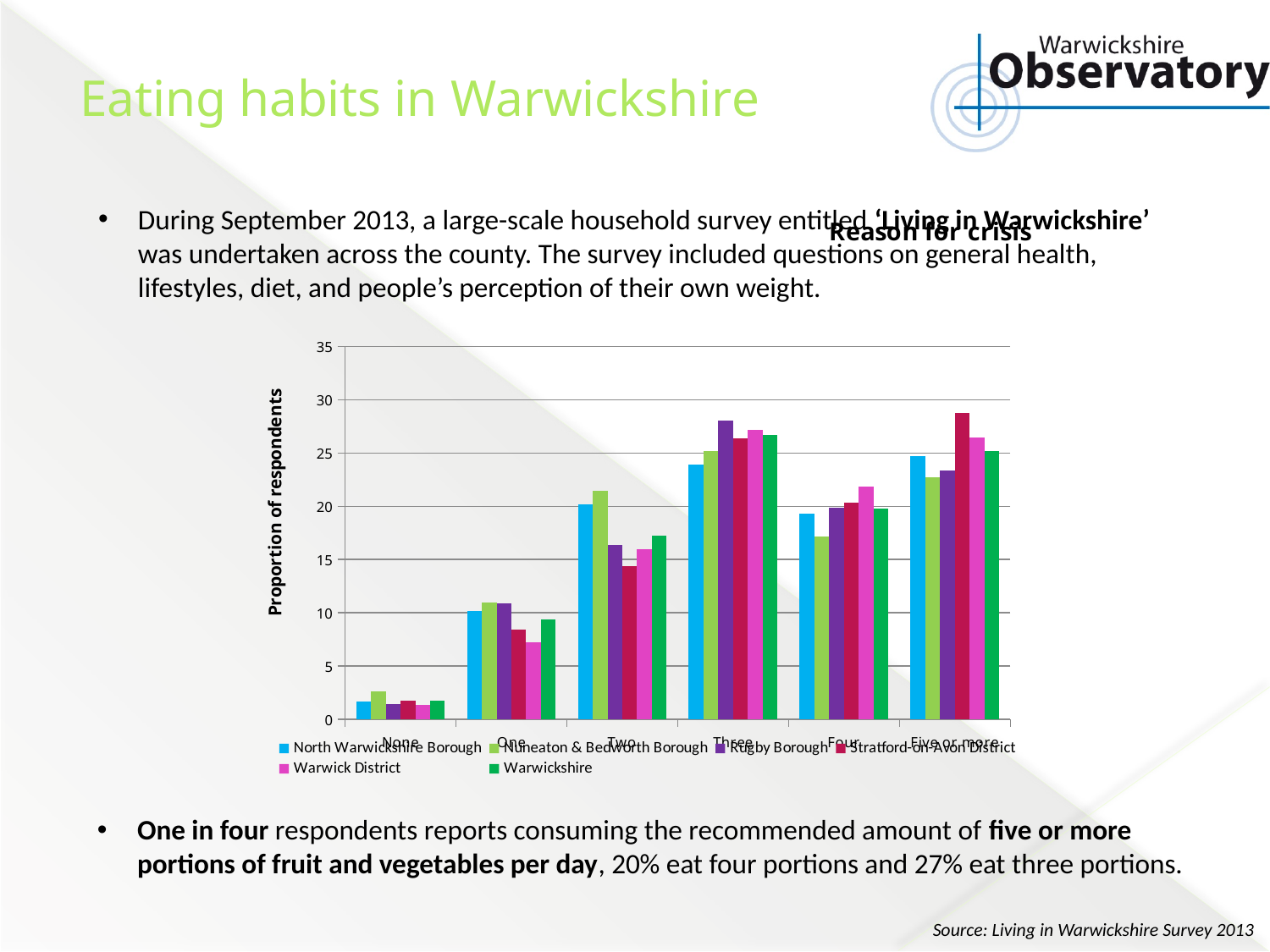
Is the value for Rugby Borough in the Three category greater or less than 25? greater Which series has the lowest value in the Two category? Stratford-on-Avon District In the Two category, which is larger: the value for Rugby Borough or the value for Stratford-on-Avon District? Rugby Borough What kind of chart is shown on the slide? bar chart Which series has the highest value in the Five or more category? Stratford-on-Avon District Do the Warwickshire values rise or fall from the None category to the Three category? rise How many categories are shown along the x axis of the chart? 6 How many series does the chart's legend list? 6 Is the value for Nuneaton & Bedworth Borough in the Four category greater or less than 20? less What is the label of the chart's vertical axis? Proportion of respondents Is the value for Warwick District in the One category greater or less than 10? less Which series has the highest value in the Four category? Warwick District